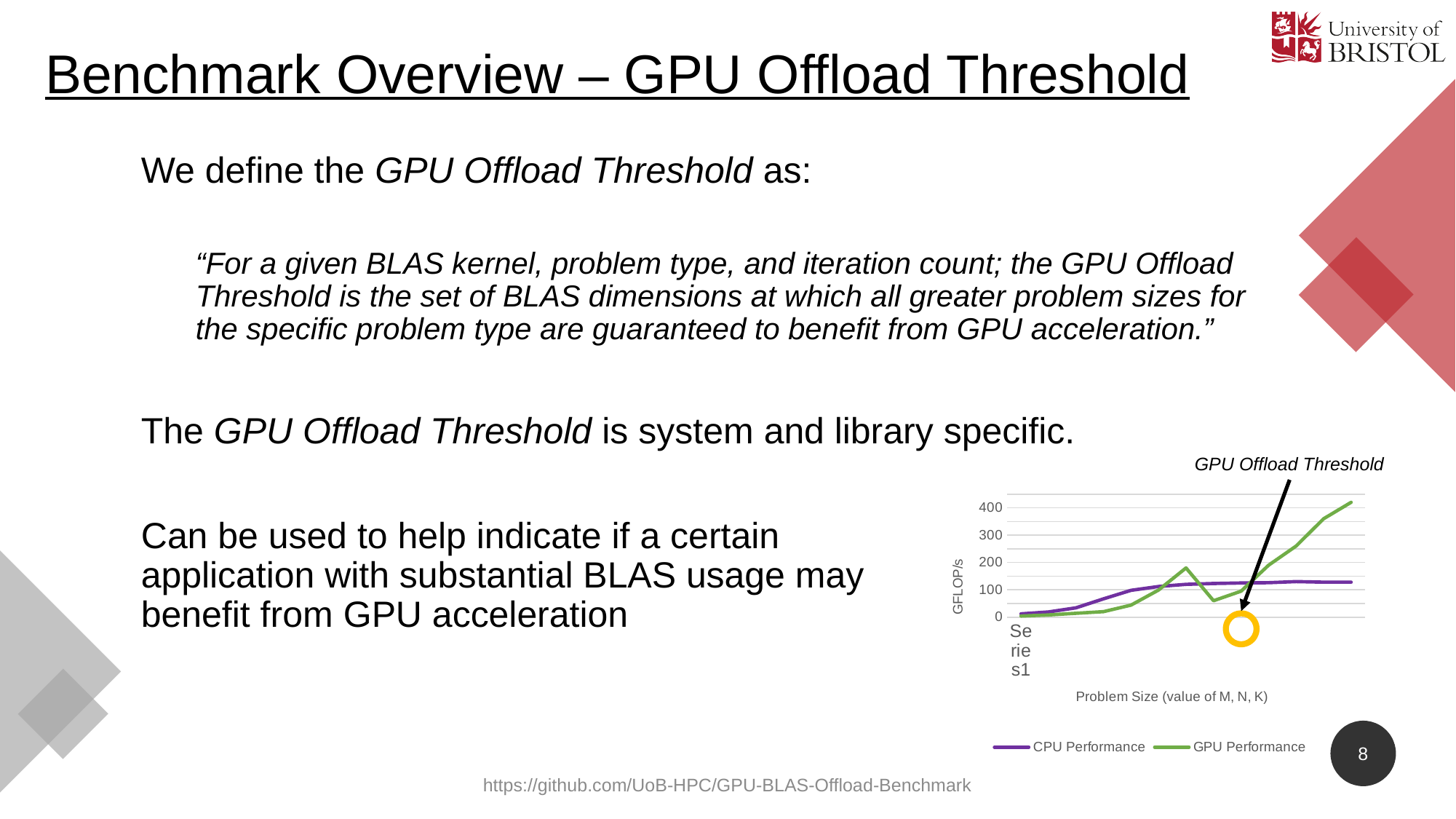
What is the highest tick value shown on the chart's y axis? 400 Is the final (rightmost) value of the GPU Performance line greater or less than 300? greater Is the starting (leftmost) value of the GPU Performance line greater or less than 100? less What are the two series named in the chart's legend? CPU Performance and GPU Performance At the right end of the chart, which series has the higher value, CPU Performance or GPU Performance? GPU Performance How many series does the chart's legend list? 2 Is the final (rightmost) value of the CPU Performance line greater or less than 200? less What is the label of the chart's y axis? GFLOP/s Does the GPU Performance line overall rise or fall from left to right across the chart? rise What kind of chart is shown on the slide? line chart